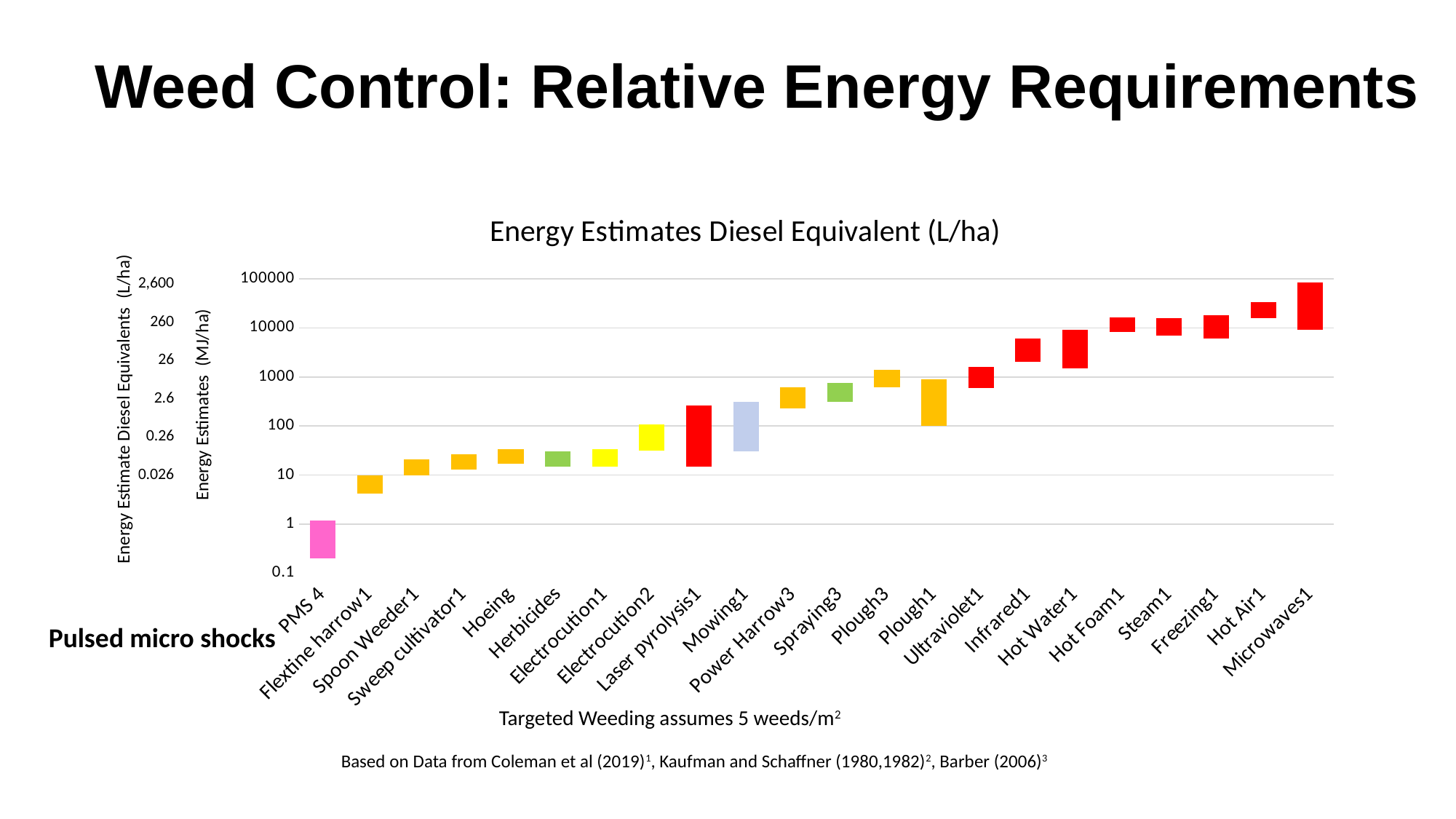
What is the title of the chart? Energy Estimates Diesel Equivalent (L/ha) What kind of chart is shown on the slide? bar chart Is the value for Hot Air1 greater or less than 10000? greater Is the value for Microwaves1 greater or less than 1000? greater Is the value for PMS 4 greater or less than 10? less What unit is given on the inner vertical axis label of the chart? MJ/ha Which category has the highest energy estimate? Microwaves1 Which category has the lowest energy estimate? PMS 4 Which has a larger energy estimate, Hot Water1 or Hoeing? Hot Water1 Do the energy estimates generally rise or fall moving from left to right along the x axis? rise How many weed control methods (categories) are plotted on the x axis? 22